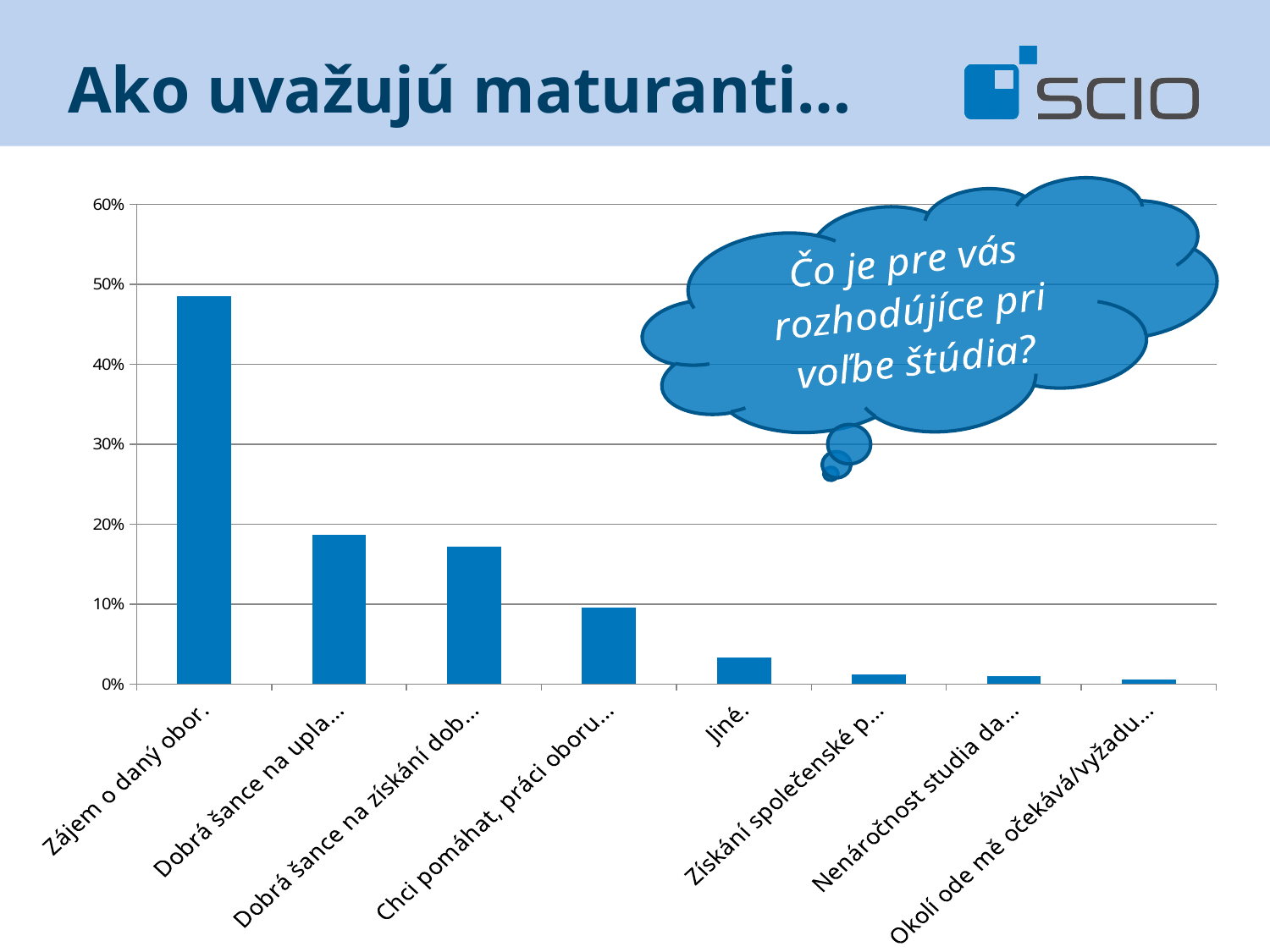
Is the value for the second bar, "Dobrá šance na upla...", greater or less than 10%? greater What kind of chart is shown on the slide? bar chart Is the value for "Zájem o daný obor." greater or less than 50%? less Is the value for "Jiné." greater or less than 10%? less Which has the larger value, "Zájem o daný obor." or "Jiné."? Zájem o daný obor. What question is written in the cloud-shaped callout next to the chart? Čo je pre vás rozhodújíce pri voľbe štúdia? What is the title of the slide containing the chart? Ako uvažujú maturanti… Do the bar values rise or fall from left to right along the x axis? fall How many categories (bars) does the chart show? 8 Which category has the highest value in the chart? Zájem o daný obor.